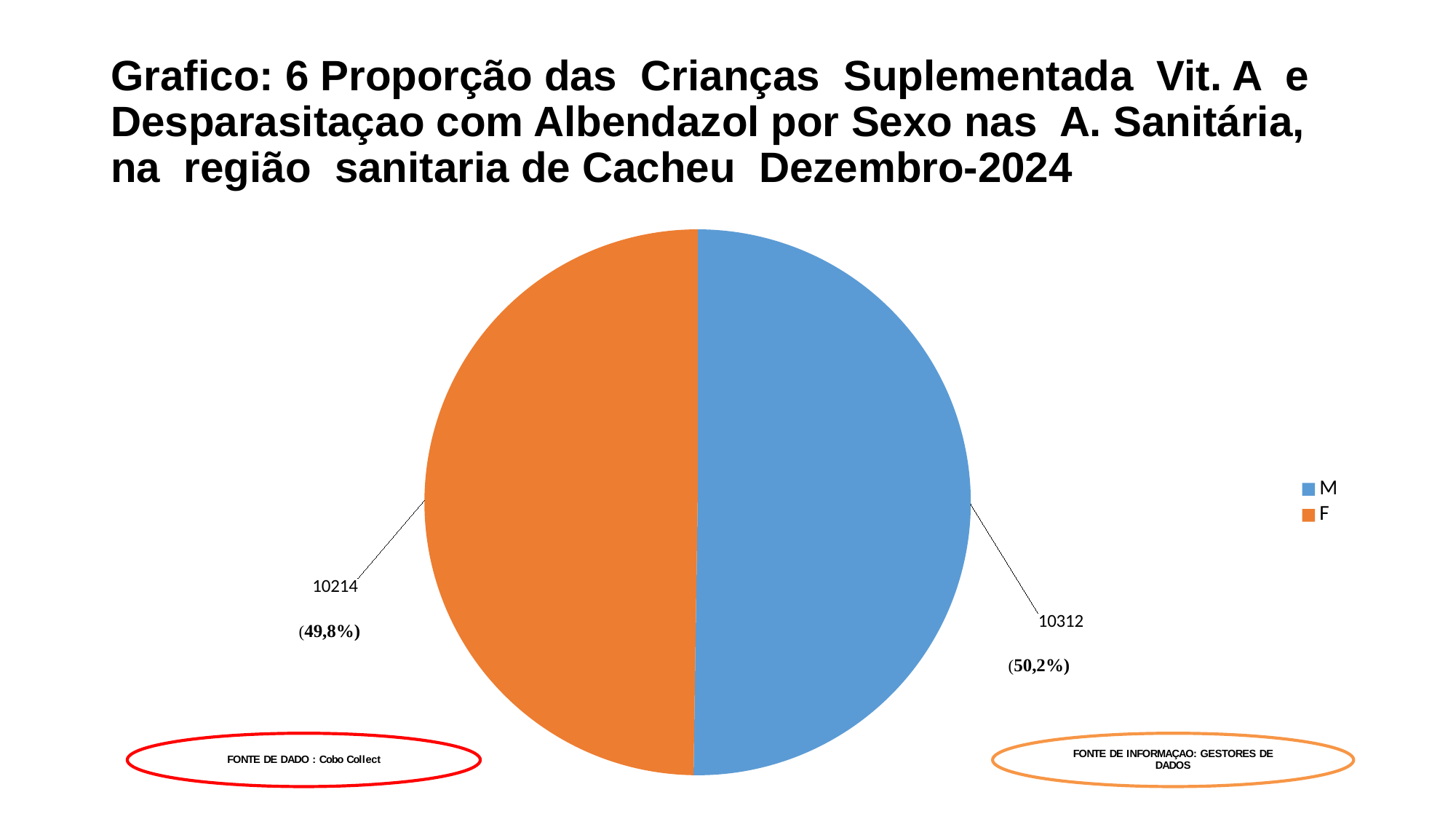
What is the value shown for the F slice of the pie chart? 10214 Which category has the smallest value in the pie chart? F What is the value shown for the M slice of the pie chart? 10312 How many slices does the pie chart have? 2 What percentage share of the pie does the F slice represent? 49,8% Which colour represents the F category in the pie chart? orange What is the difference between the values for M and F? 98 How many entries does the legend list? 2 What type of chart is shown on the slide? pie chart What is the total of the two values shown in the pie chart? 20526 Which category has the larger value, M or F? M What percentage share of the pie does the M slice represent? 50,2%